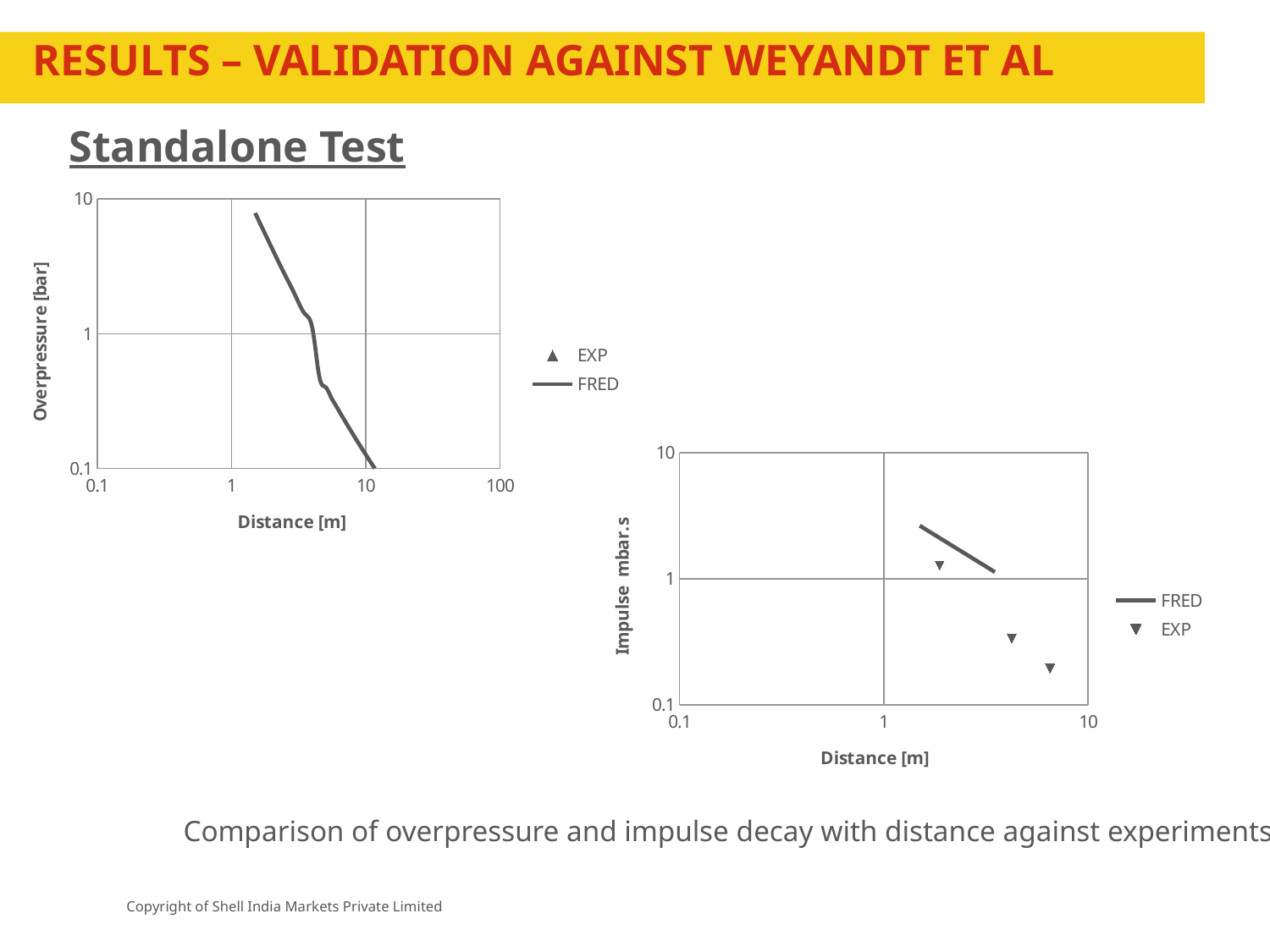
How many EXP data points are plotted on the right chart (Impulse vs Distance)? 3 On the left chart, does the FRED overpressure rise or fall as distance increases? fall What kind of chart is the right chart (Impulse vs Distance)? line chart with scatter points What is the highest tick value shown on the x-axis of the left chart? 100 What is the x-axis label of the right chart? Distance [m] On the left chart, is the FRED overpressure at a distance of 10 m greater or less than 1 bar? less On the right chart, does the FRED impulse rise or fall as distance increases? fall On the right chart, is the FRED impulse at a distance of about 2 m greater or less than 1 mbar.s? greater On the right chart, is the EXP impulse at a distance of about 4 m greater or less than 1 mbar.s? less What are the two legend entries on the right chart (Impulse vs Distance)? FRED and EXP What is the y-axis label of the left chart? Overpressure [bar] How many series does the legend of the left chart (Overpressure vs Distance) list? 2